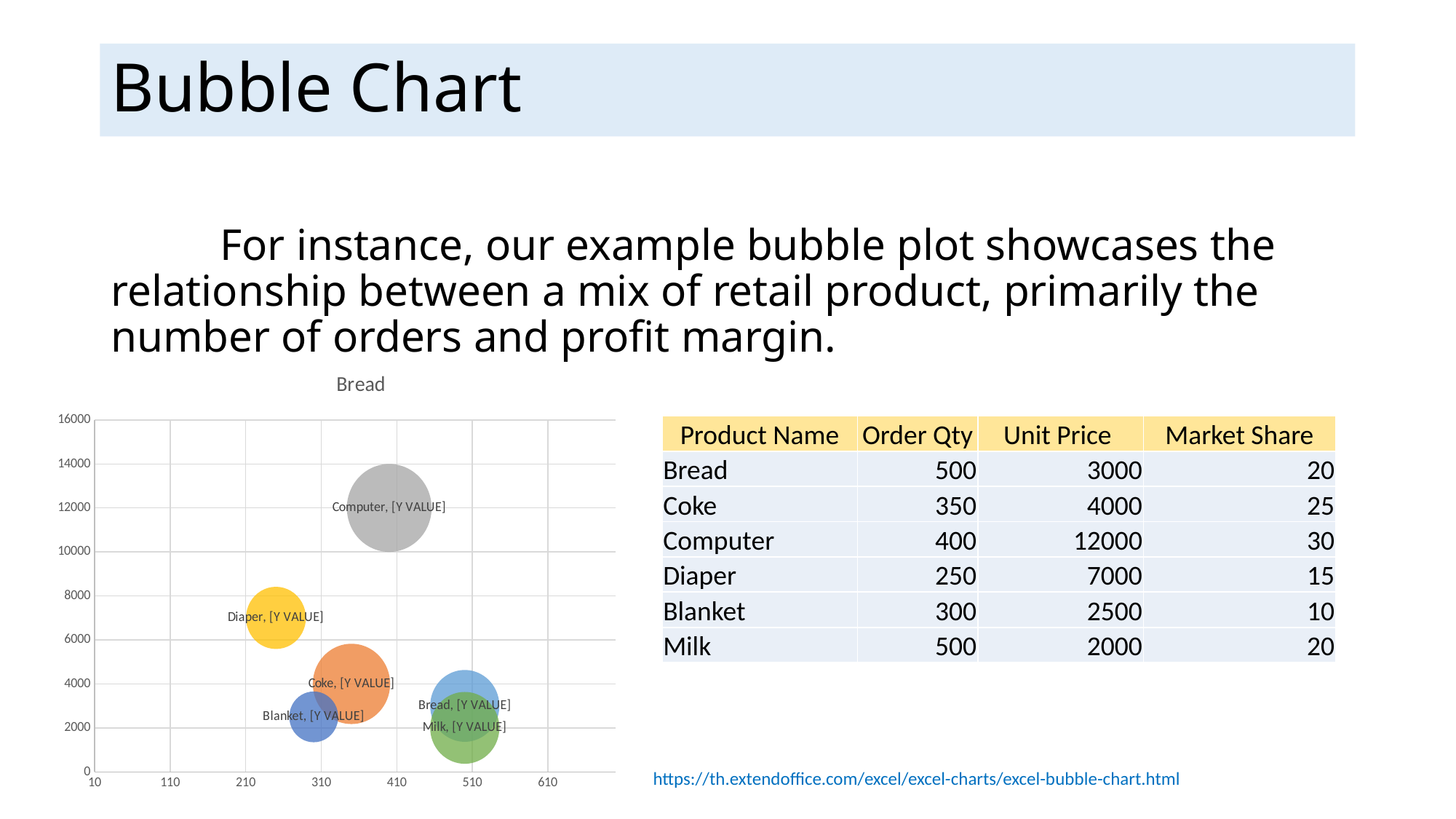
What is the title of the chart? Bread Which bubble is higher on the y axis, Computer or Diaper? Computer Which bubble is higher on the y axis, Diaper or Coke? Diaper Which product's bubble is positioned highest on the y axis? Computer What kind of chart is shown on the slide? bubble chart Which product's bubble is positioned furthest left on the x axis? Diaper Is the y value for the Blanket bubble greater or less than 4000? less According to the table on the slide, what is the Order Qty for Computer? 400 What colour is the Computer bubble? gray Is the x value for the Diaper bubble greater or less than 310? less Is the y value for the Computer bubble greater or less than 10000? greater How many bubbles are plotted in the chart? 6